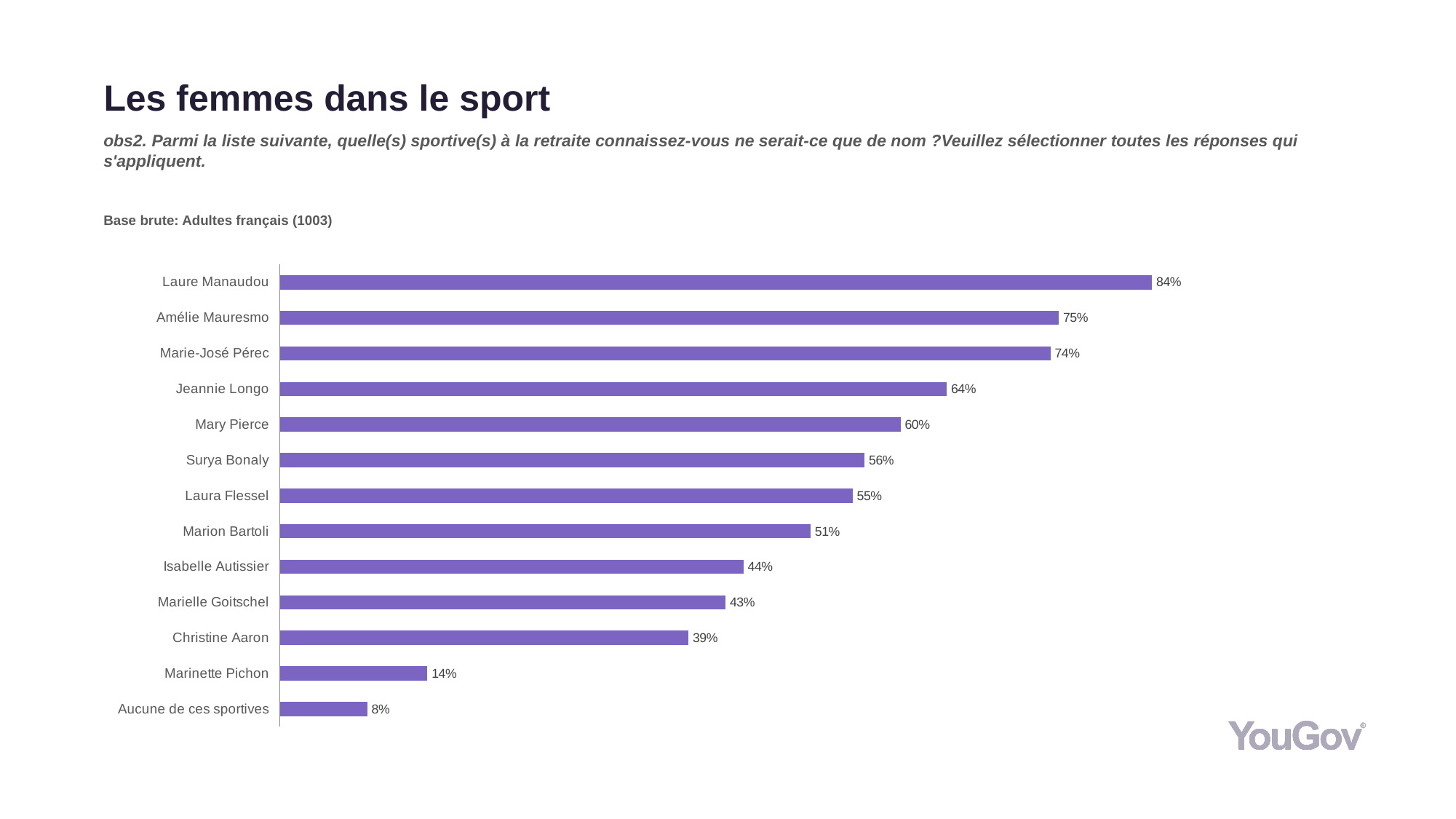
What is the value shown for Marinette Pichon? 14% Which category has the lowest value? Aucune de ces sportives Which category has the highest value? Laure Manaudou What percentage of respondents know Laure Manaudou? 84% Which has a higher value, Mary Pierce or Marion Bartoli? Mary Pierce What is the difference between the values for Christine Aaron and Marinette Pichon? 25 percentage points What is the base (sample) stated on the slide? Adultes français (1003) What is the difference between the values for Amélie Mauresmo and Jeannie Longo? 11 percentage points What is the value shown for Surya Bonaly? 56% What is the value shown for Isabelle Autissier? 44% What kind of chart is shown on the slide? Bar chart How many categories are shown in the chart? 13